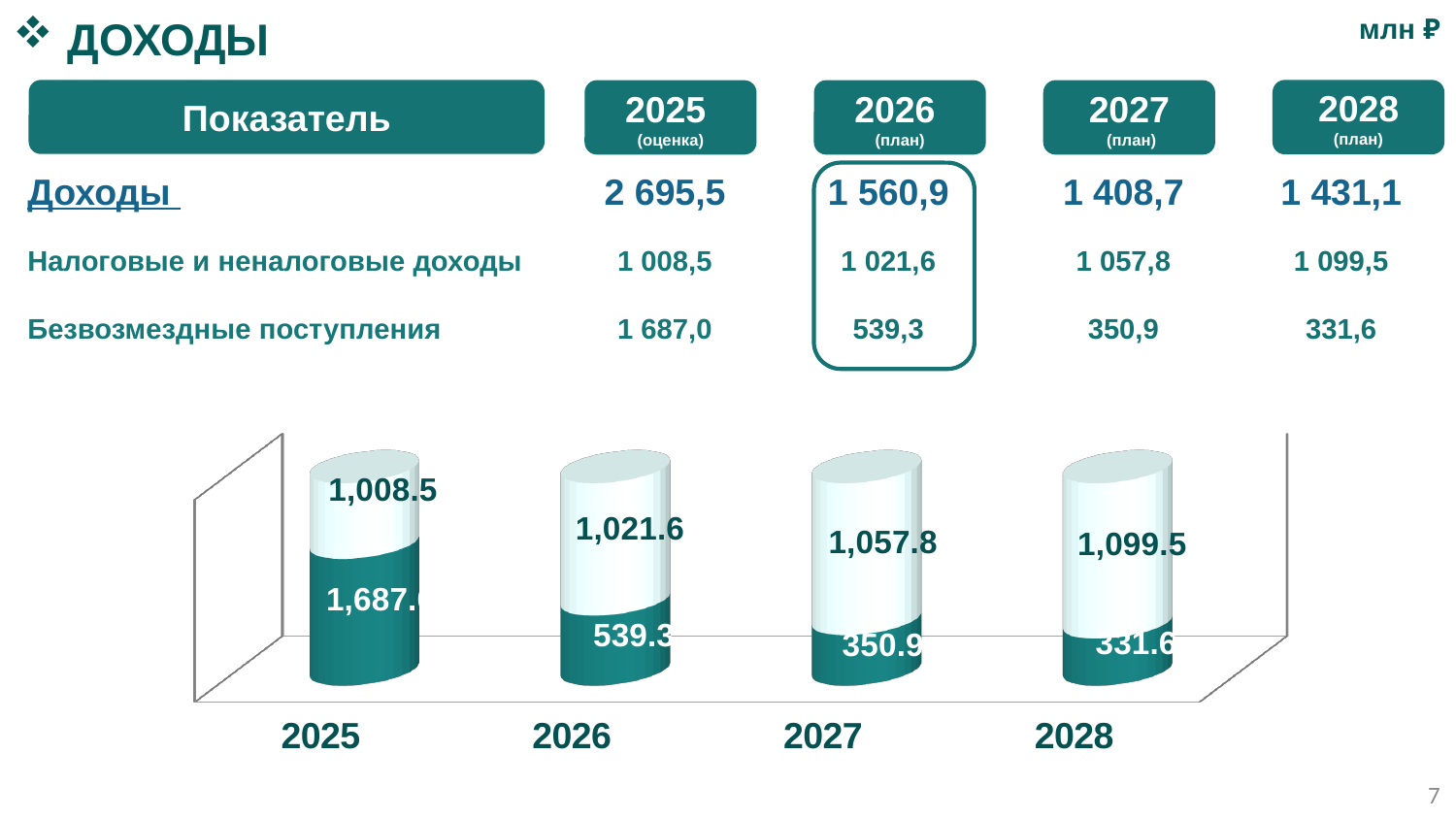
What is the value of the dark teal (lower) segment for 2027 in the chart? 350.9 What is the total of the stacked bar for 2027? 1,408.7 What is the value of the light (upper) segment for 2028 in the chart? 1,099.5 Do the values of the light (upper) segments rise or fall from 2025 to 2028? Rise In which year is the dark teal (lower) segment the largest? 2025 How many years are plotted along the x axis of the chart? 4 What is the value of the dark teal (lower) segment for 2026 in the chart? 539.3 In which year is the dark teal (lower) segment the smallest? 2028 What kind of chart is shown on the slide? Stacked bar chart What is the difference between the light segment and the dark teal segment for 2026? 482.3 Which is larger: the dark teal segment for 2026 or the dark teal segment for 2027? 2026 What is the value of the light (upper) segment for 2026 in the chart? 1,021.6